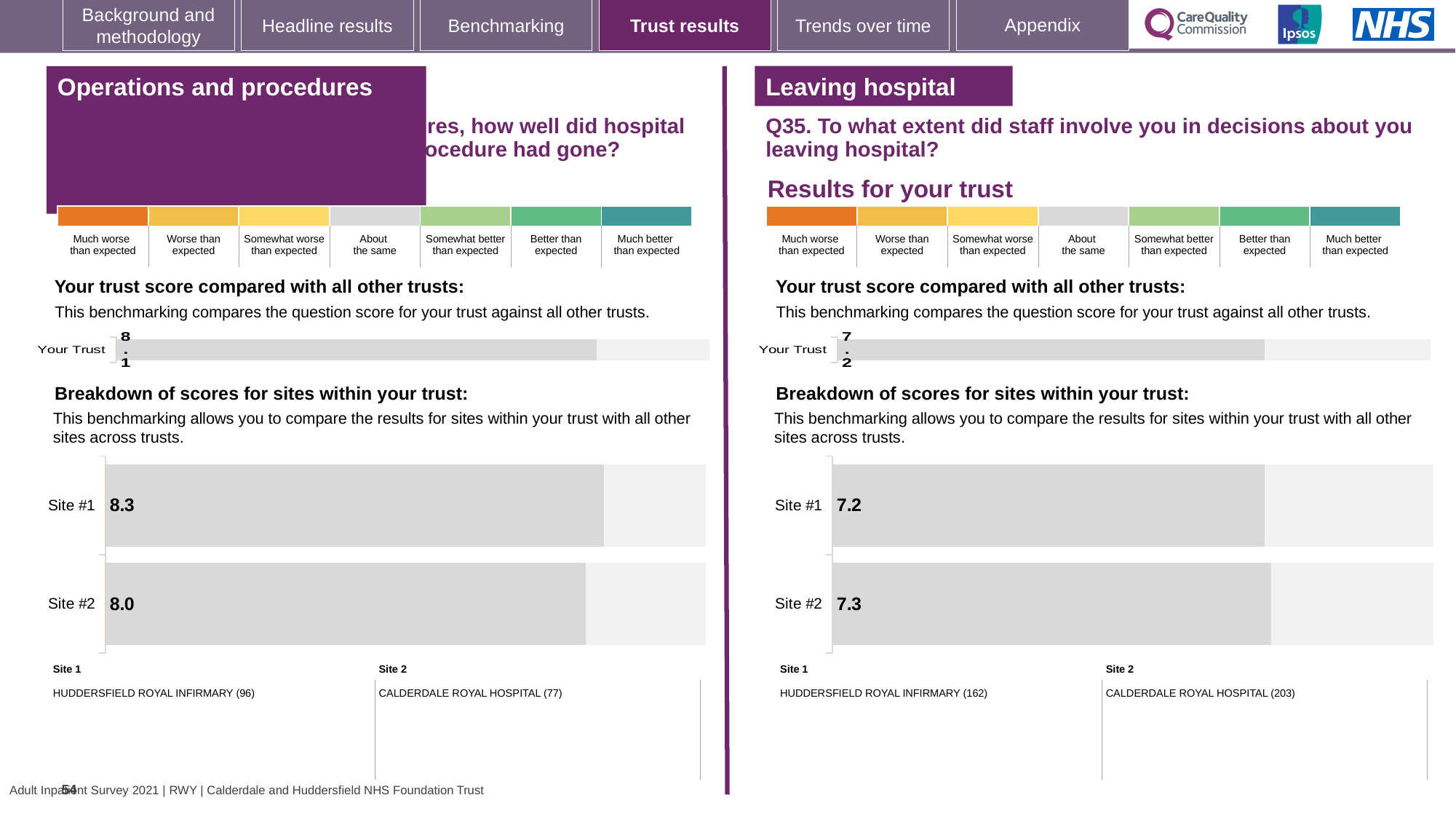
In the 'Operations and procedures' section, what is the score shown for Site #1 in the breakdown of scores for sites within your trust? 8.3 In the 'Operations and procedures' section, what is the score shown for Site #2 in the breakdown of scores for sites within your trust? 8.0 In the 'Leaving hospital' section (Q35), what is the score shown for Site #1 in the breakdown of scores for sites within your trust? 7.2 What type of chart is used for the breakdown of scores for sites within your trust in the 'Operations and procedures' section? Bar chart In the 'Operations and procedures' site breakdown chart, what is the difference between the Site #1 and Site #2 scores? 0.3 In the 'Leaving hospital' (Q35) site breakdown chart, what is the difference between the Site #2 and Site #1 scores? 0.1 In the 'Leaving hospital' section (Q35), what is the score shown for Site #2 in the breakdown of scores for sites within your trust? 7.3 In the 'Operations and procedures' section, what is the 'Your Trust' score in the chart comparing your trust with all other trusts? 8.1 In the 'Leaving hospital' section (Q35), what is the 'Your Trust' score in the chart comparing your trust with all other trusts? 7.2 In the 'Leaving hospital' (Q35) site breakdown chart, which site has the lower score? Site #1 How many sites are shown in the 'Leaving hospital' (Q35) breakdown of scores for sites within your trust chart? 2 In the 'Operations and procedures' site breakdown chart, which site has the higher score? Site #1